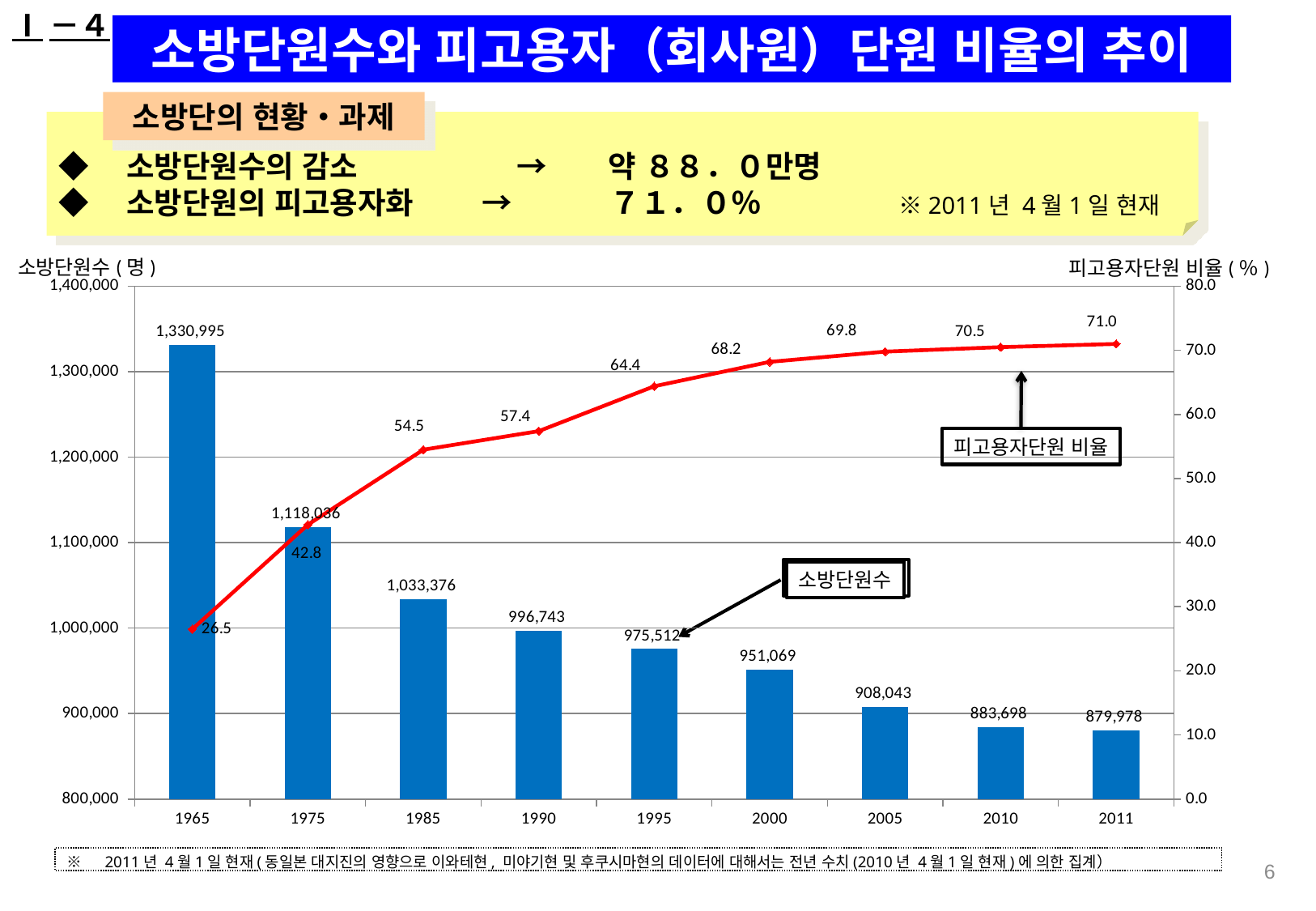
What is the number of fire corps members (소방단원수) in 2011? 879,978 What is the employee member ratio (피고용자단원 비율) in 1965? 26.5 Which year has more fire corps members (소방단원수), 1985 or 2000? 1985 What is the number of fire corps members (소방단원수) in 1965? 1,330,995 Is the number of fire corps members (소방단원수) in 2005 greater or less than 900,000? greater How many years are shown on the x axis of the chart? 9 What is the difference in the number of fire corps members (소방단원수) between 2010 and 2011? 3,720 Which year has the highest number of fire corps members (소방단원수)? 1965 How does the number of fire corps members (소방단원수) change from 1965 to 2011? It falls What is the difference in the employee member ratio (피고용자단원 비율) between 2011 and 2010? 0.5 Which year has the lowest employee member ratio (피고용자단원 비율)? 1965 What is the employee member ratio (피고용자단원 비율) in 1995? 64.4